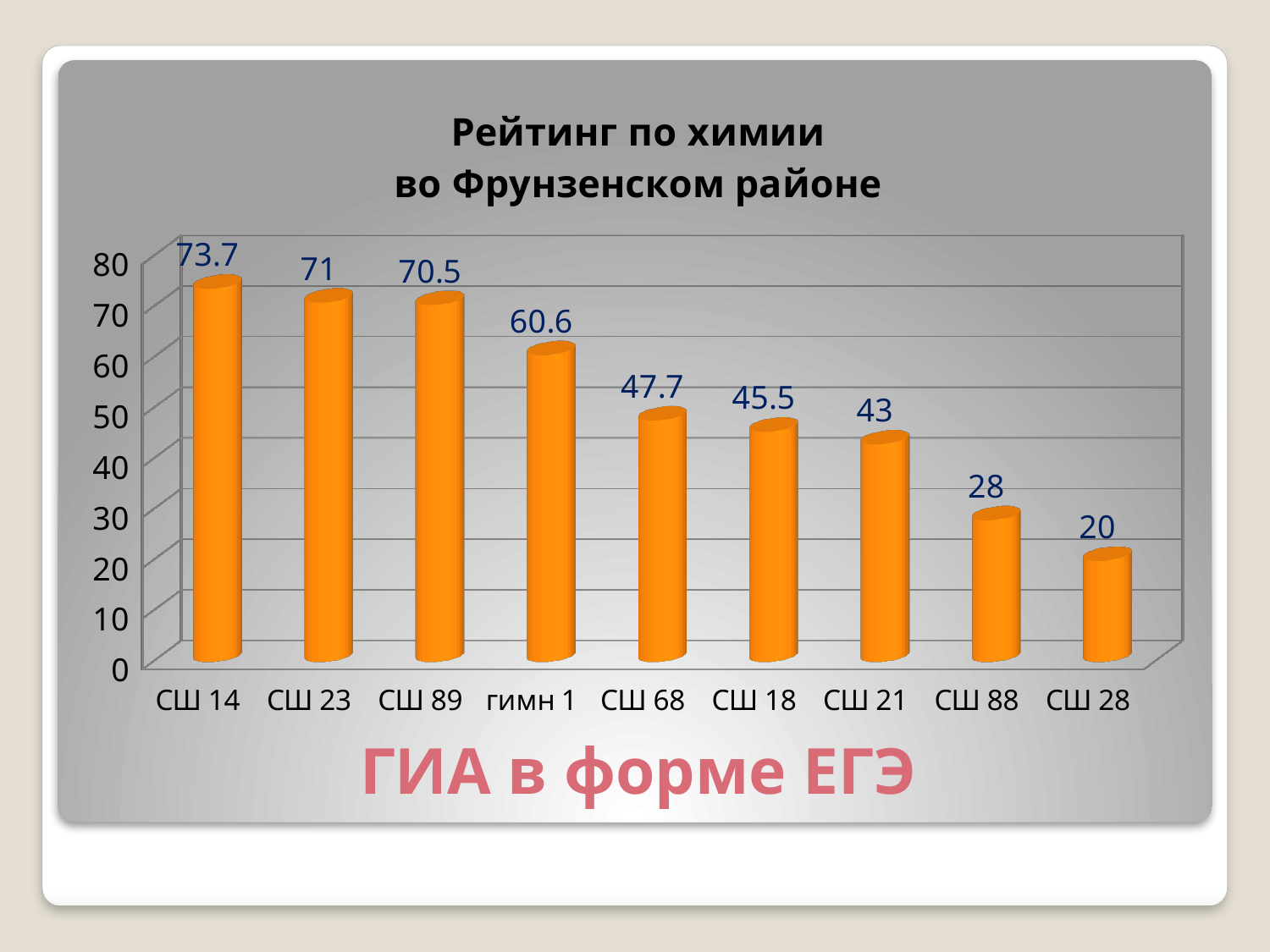
What is the difference between the values for СШ 14 and СШ 28? 53.7 What is the value for СШ 14? 73.7 What is the difference between the values for СШ 68 and СШ 21? 4.7 What is the value for гимн 1? 60.6 Do the values rise or fall from left to right along the x axis? fall Is the value for СШ 88 greater or less than 30? less Which category has the lowest value? СШ 28 What is the value for СШ 18? 45.5 How many categories are shown on the x axis? 9 Which category has the highest value? СШ 14 What kind of chart is shown on the slide? bar chart Which is larger, the value for СШ 23 or the value for гимн 1? СШ 23